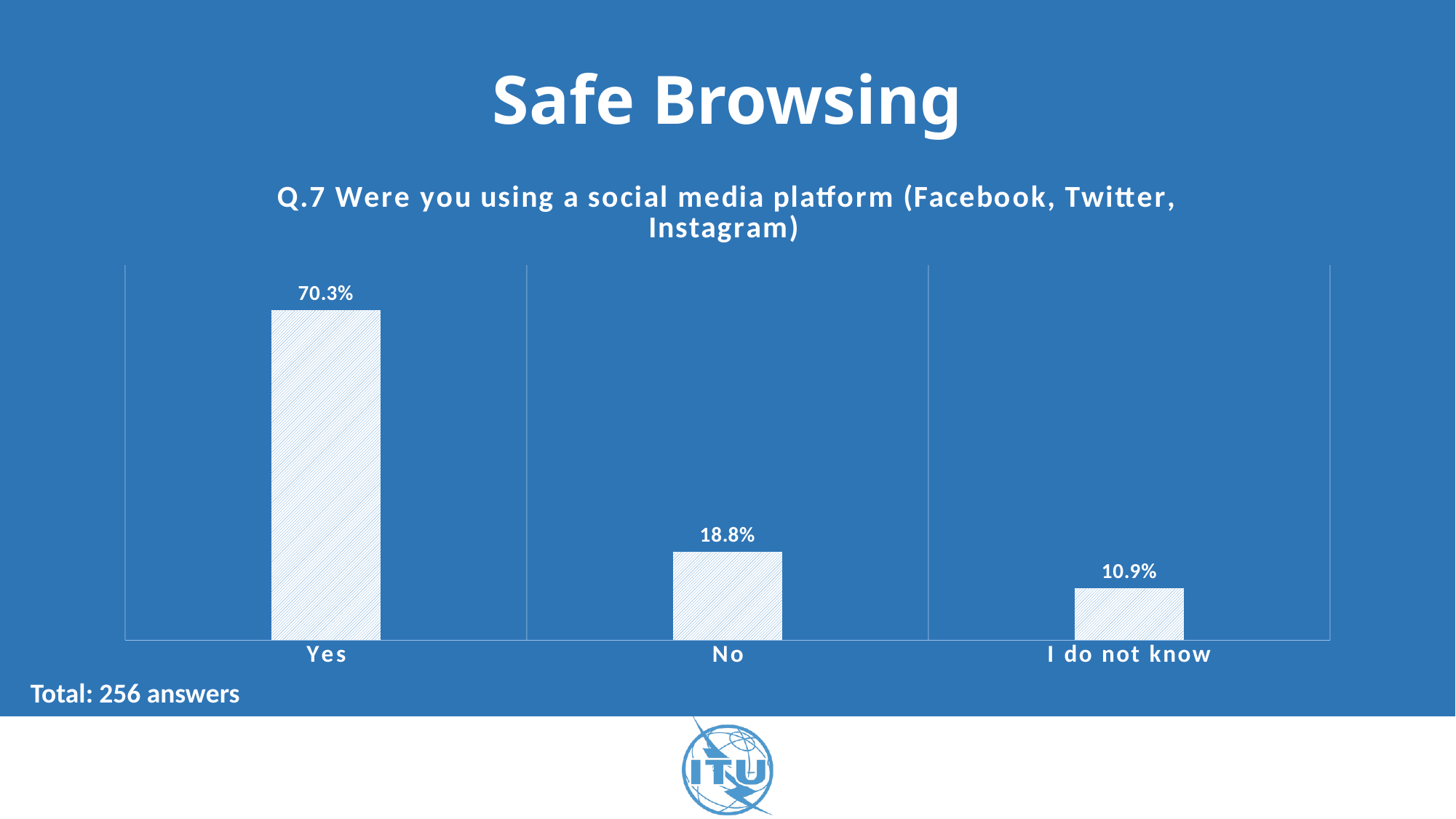
How many categories are shown on the chart? 3 What is the title of the chart? Q.7 Were you using a social media platform (Facebook, Twitter, Instagram) What is the difference between the values for "Yes" and "No"? 51.5% Which category has the lowest value? I do not know Do the values rise or fall from left to right across the categories? Fall What is the value for "I do not know"? 10.9% Which category has the highest value? Yes What kind of chart is shown on the slide? Bar chart What is the difference between the values for "No" and "I do not know"? 7.9% What is the value for "No"? 18.8% Which is larger, the value for "No" or the value for "I do not know"? No What is the value for "Yes"? 70.3%